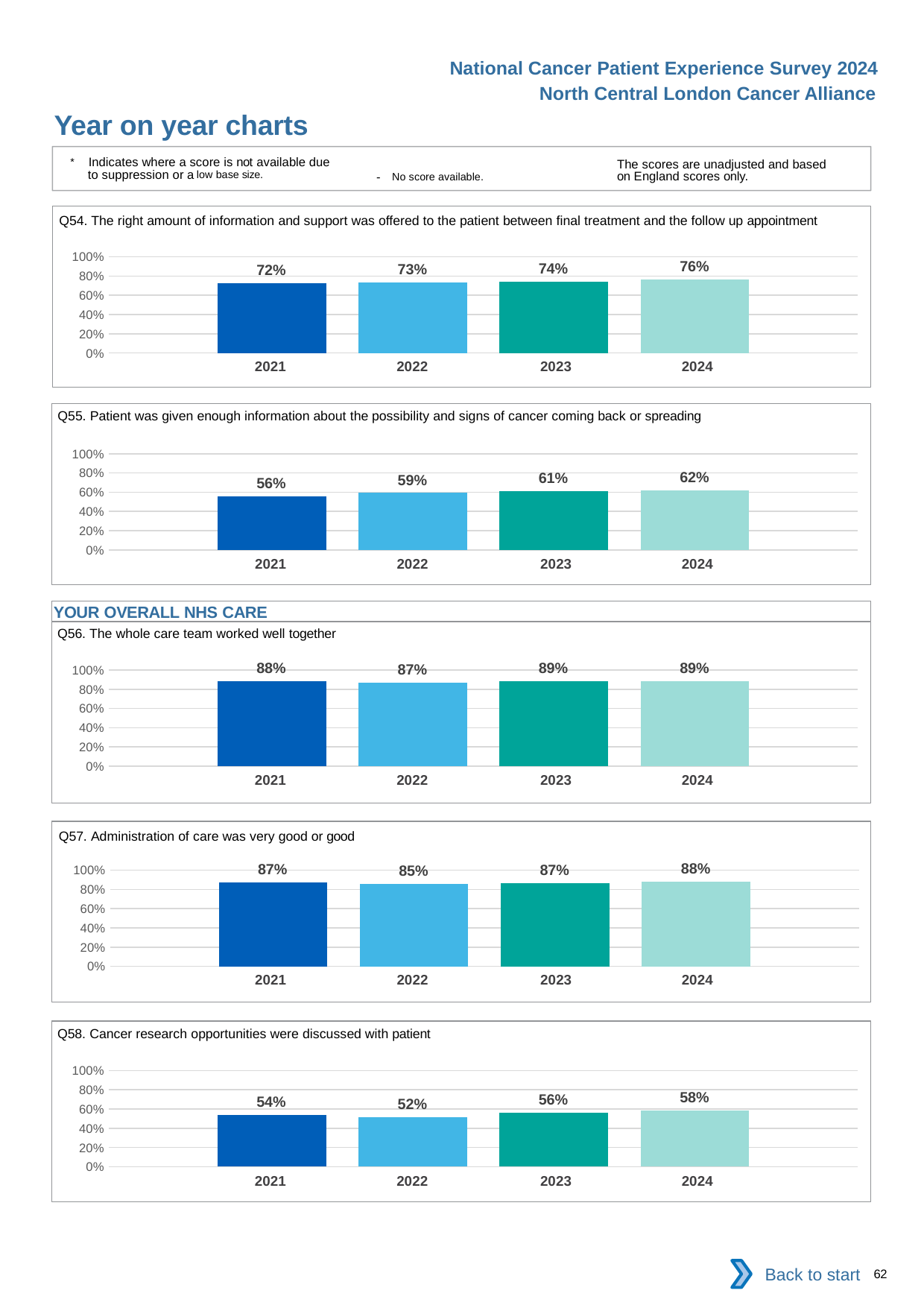
In the Q58 chart, what is the value for 2022? 52% How many years are shown in the Q54 chart? 4 In the Q56 chart, what is the value for 2022? 87% In the Q57 chart, which year has the highest value? 2024 What is the section heading shown above the Q56 chart? YOUR OVERALL NHS CARE In the Q55 chart, which year has the lowest value? 2021 In the Q58 chart, what is the difference between the 2024 and 2022 values? 6% In the Q55 chart, what is the difference between the 2024 and 2021 values? 6% In the Q54 chart, do the values rise or fall from 2021 to 2024? Rise What kind of chart is the Q55 chart? Bar chart In the Q57 chart, which is larger, the value for 2021 or the value for 2022? 2021 In the Q54 chart, what is the value for 2024? 76%